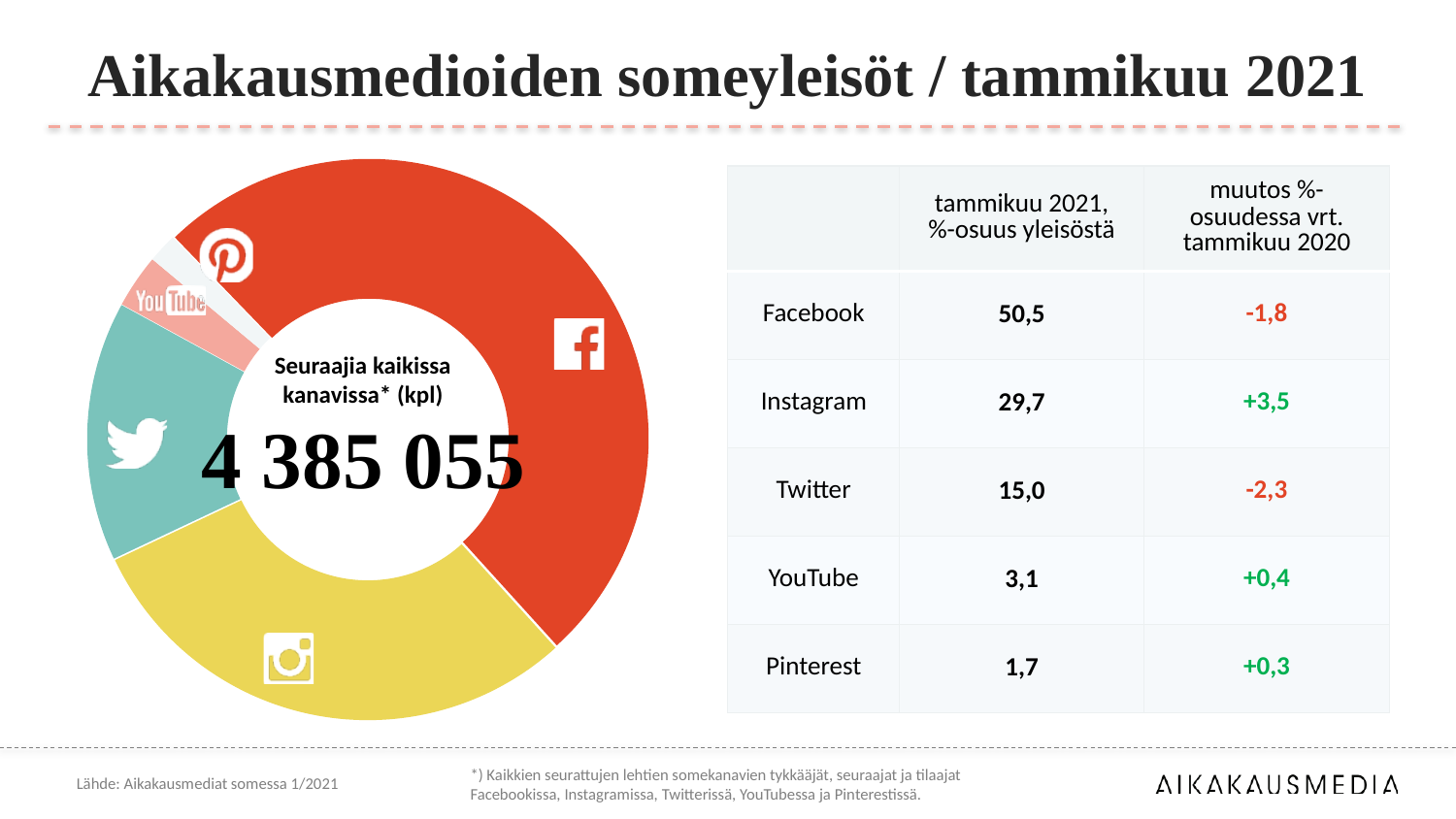
What total number of followers across all channels is shown in the centre of the donut chart? 4 385 055 What is Instagram's share of the audience in January 2021, according to the table? 29,7 What is the change in YouTube's share compared with January 2020? +0,4 Which is larger, the Instagram slice or the Twitter slice? Instagram Which channel has the largest slice in the donut chart? Facebook How many social media channels are shown as slices in the donut chart? 5 What is the difference between Facebook's and Instagram's shares in January 2021? 20,8 What is Facebook's share of the audience in January 2021, according to the table? 50,5 Which channel had the largest decrease in share compared with January 2020? Twitter Which channel has the smallest slice in the donut chart? Pinterest What is Twitter's share of the audience in January 2021? 15,0 What kind of chart is shown on the left of the slide? Donut (pie) chart